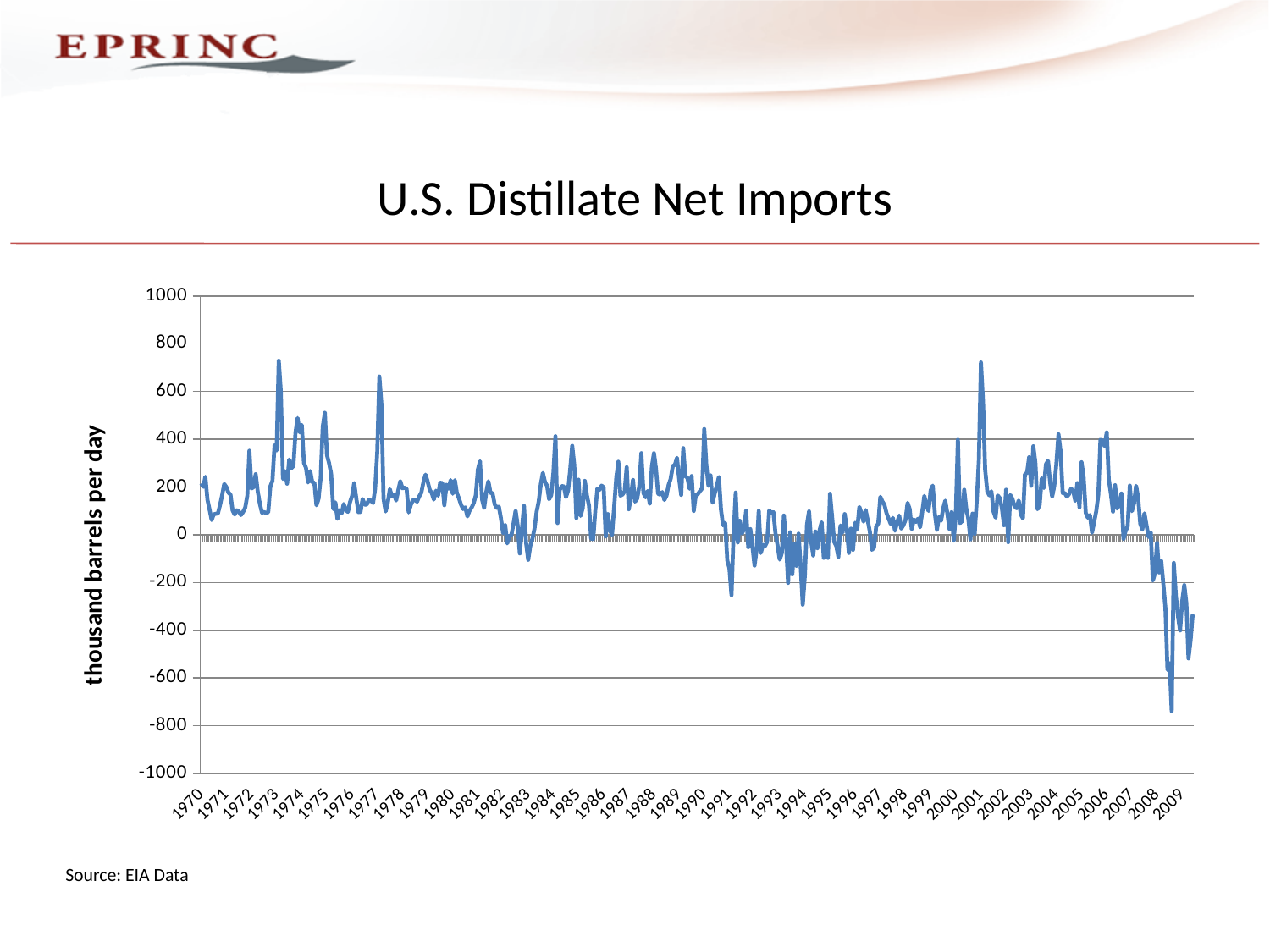
Is the peak value reached in 2001 greater or less than 600? greater Comparing the value at the start of 1970 with the value at the end of 2009, which is larger? 1970 Is the value at the start of 1970 greater or less than 0? greater Is the value at the end of 2009 greater or less than -200? less What kind of chart is shown on the slide? line chart What is the label on the vertical axis of the chart? thousand barrels per day What is the title of the chart? U.S. Distillate Net Imports What is the highest value shown on the vertical axis? 1000 How many year labels are shown along the x axis of the chart? 40 Do the values rise or fall between 2007 and 2009? fall